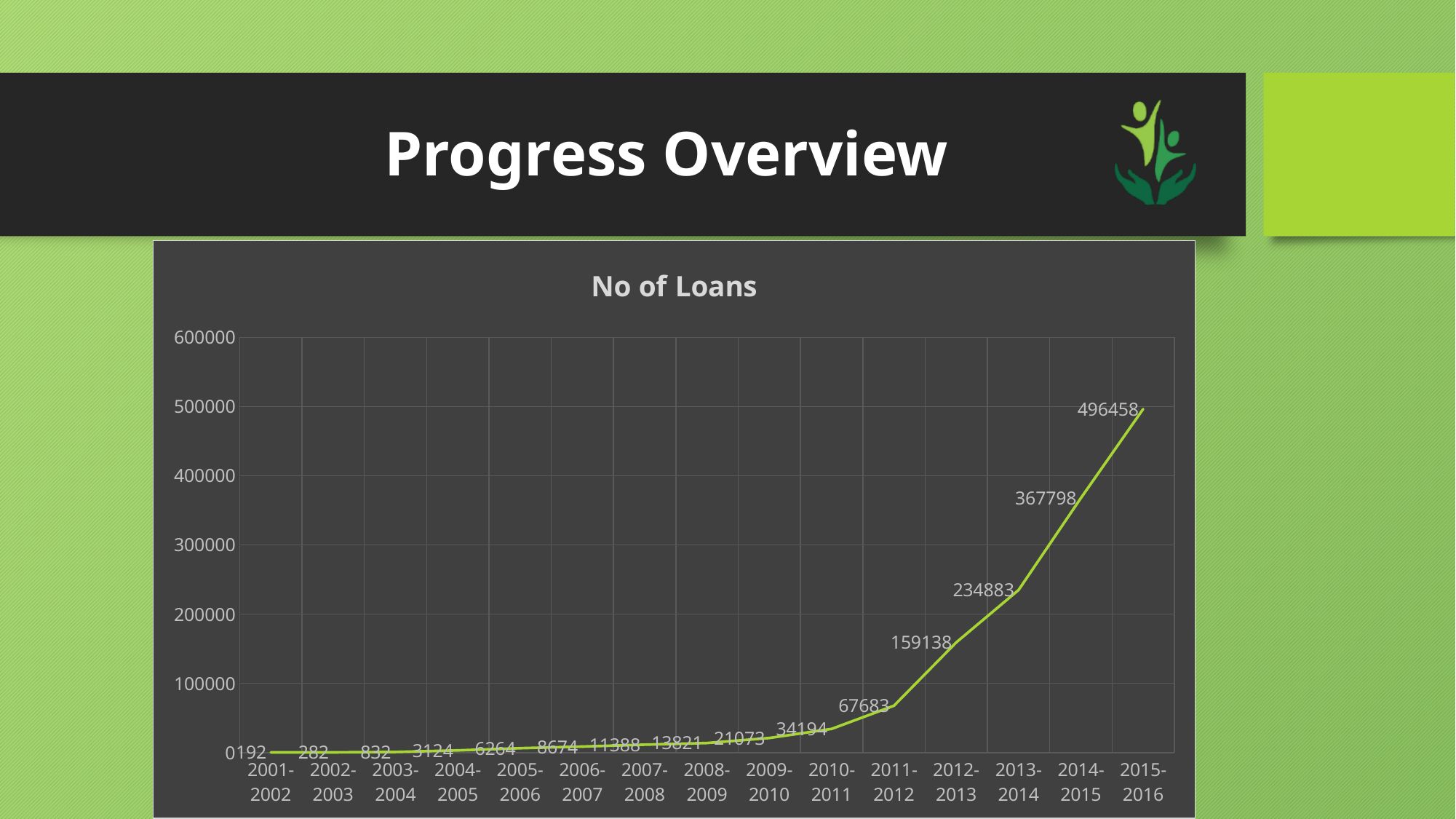
What is the difference in the number of loans between 2015-2016 and 2014-2015? 128660 What is the number of loans for 2013-2014? 234883 What is the title of the chart? No of Loans Do the values rise or fall from 2001-2002 to 2015-2016? rise What kind of chart is shown on the slide? line chart How many periods are plotted along the x axis? 15 Which period has the highest number of loans? 2015-2016 What is the number of loans for 2009-2010? 21073 What is the number of loans for 2011-2012? 67683 Which period has more loans, 2012-2013 or 2013-2014? 2013-2014 What is the number of loans for 2015-2016? 496458 Which period has the lowest number of loans? 2001-2002